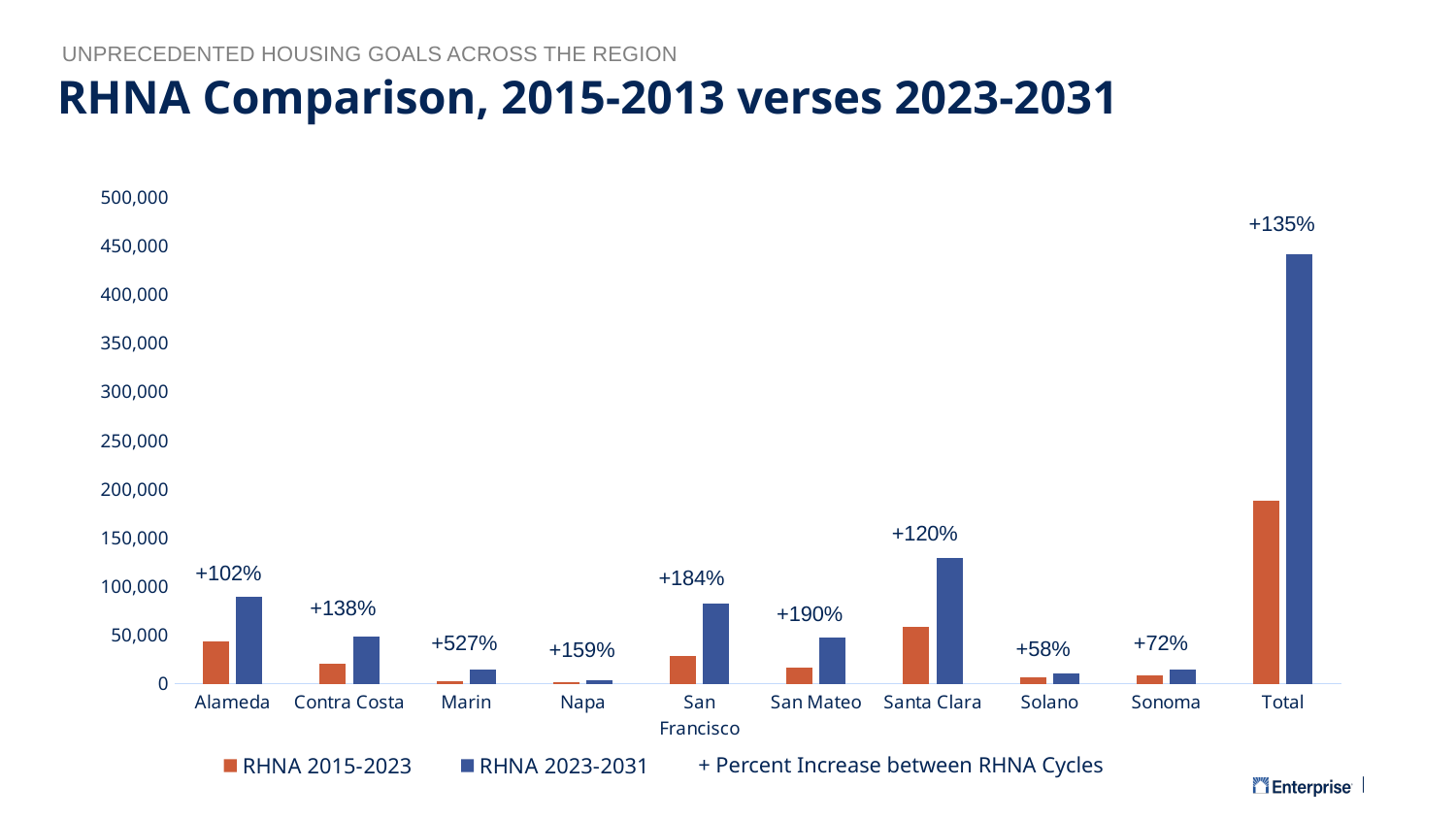
How many percentage points higher is the percent increase for San Mateo than for San Francisco? 6 What is the percent increase between RHNA cycles shown for Santa Clara? +120% Which has the larger RHNA 2023-2031 bar, Santa Clara or Alameda? Santa Clara What is the percent increase between RHNA cycles shown for Marin? +527% What kind of chart is shown on the slide? bar chart Is the RHNA 2015-2023 value for Total greater or less than 200,000? less Which county has the highest percent increase between RHNA cycles? Marin Is the RHNA 2023-2031 value for Total greater or less than 400,000? greater How many series of bars does the legend list? 2 How many categories are shown along the x axis of the chart? 10 Which county has the lowest percent increase between RHNA cycles? Solano What is the percent increase between RHNA cycles shown for the Total? +135%